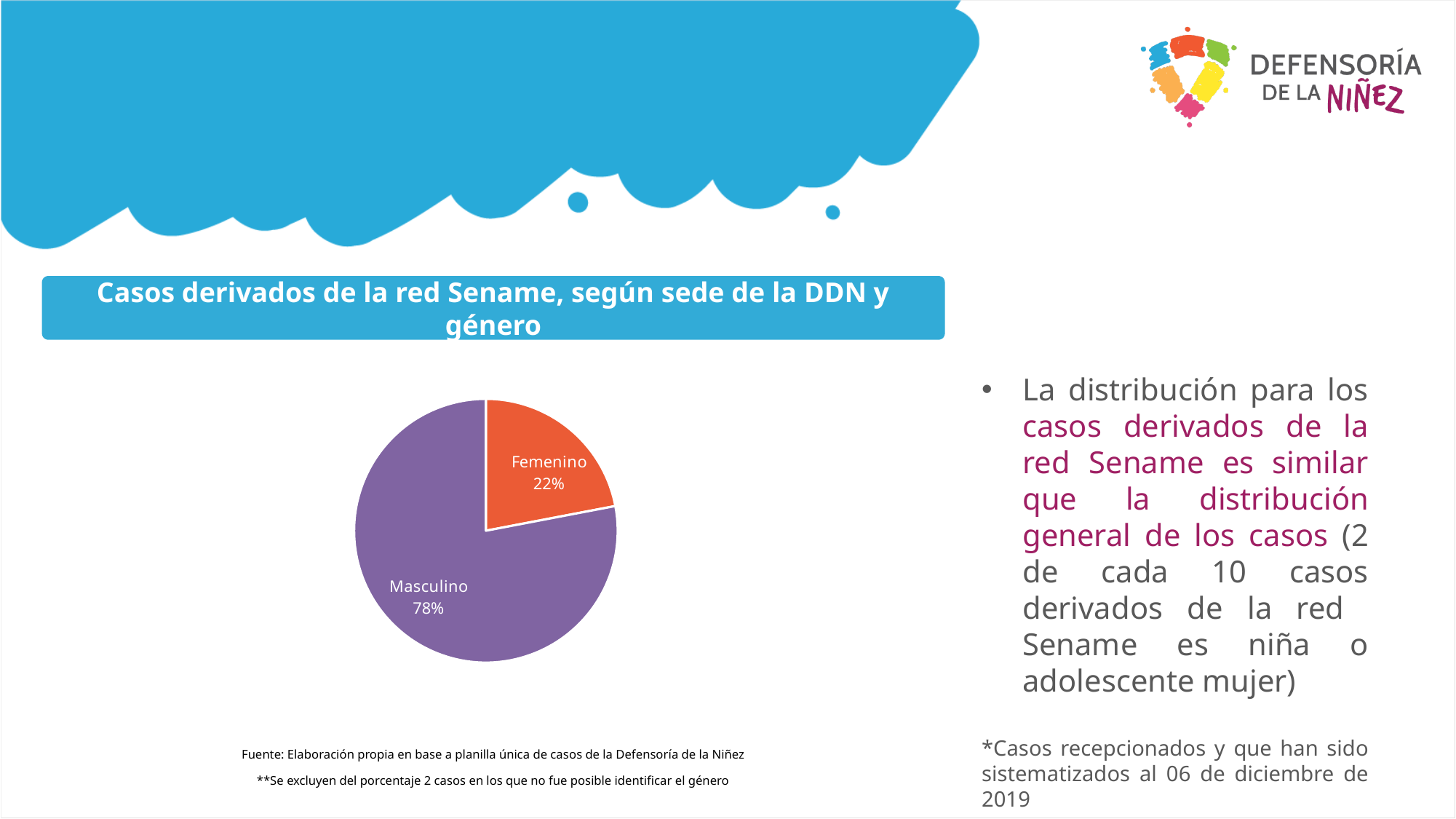
Which category has the largest share of the pie chart? Masculino What colour is the Masculino slice of the pie chart? purple What is the title of the chart? Casos derivados de la red Sename, según sede de la DDN y género What percentage of the pie chart is Femenino? 22% Which category has the smallest share of the pie chart? Femenino How many slices does the pie chart have? 2 What kind of chart is shown on the slide? pie chart What share of the pie does the Femenino slice represent? 22% Which is larger, the Masculino slice or the Femenino slice? Masculino What percentage of the pie chart is Masculino? 78% What is the difference in percentage points between Masculino and Femenino? 56